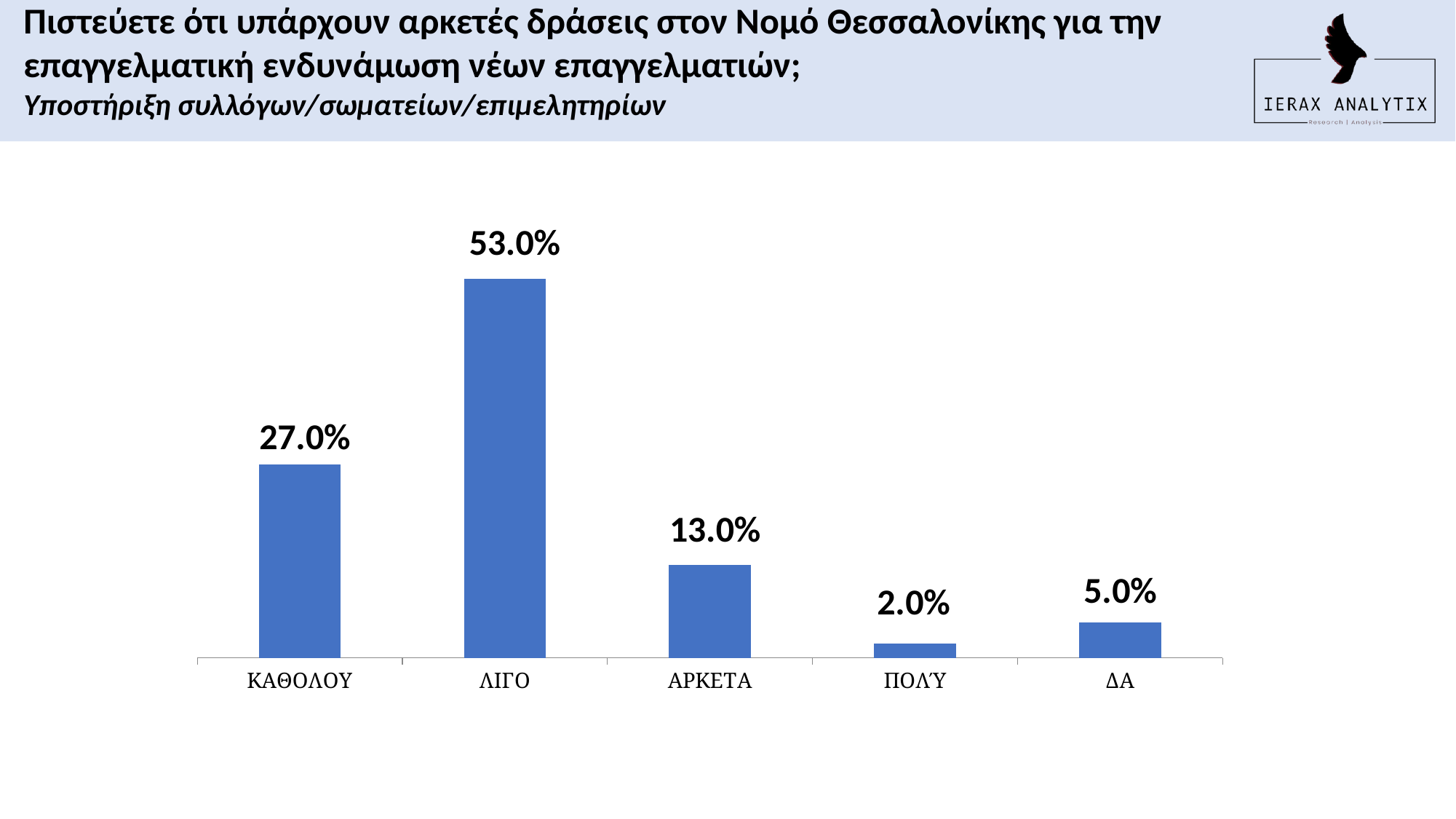
Which is larger, the value for ΑΡΚΕΤΑ or the value for ΔΑ? ΑΡΚΕΤΑ Which category has the lowest value? ΠΟΛΎ What is the value for ΑΡΚΕΤΑ? 13.0% How many categories are shown on the x axis? 5 What is the value for ΔΑ? 5.0% What is the value for ΛΙΓΟ? 53.0% What is the value for ΠΟΛΎ? 2.0% What kind of chart is shown on the slide? Bar chart What is the difference between the values for ΛΙΓΟ and ΚΑΘΟΛΟΥ? 26.0% What is the value for ΚΑΘΟΛΟΥ? 27.0% Which category has the highest value? ΛΙΓΟ What is the difference between the values for ΑΡΚΕΤΑ and ΠΟΛΎ? 11.0%